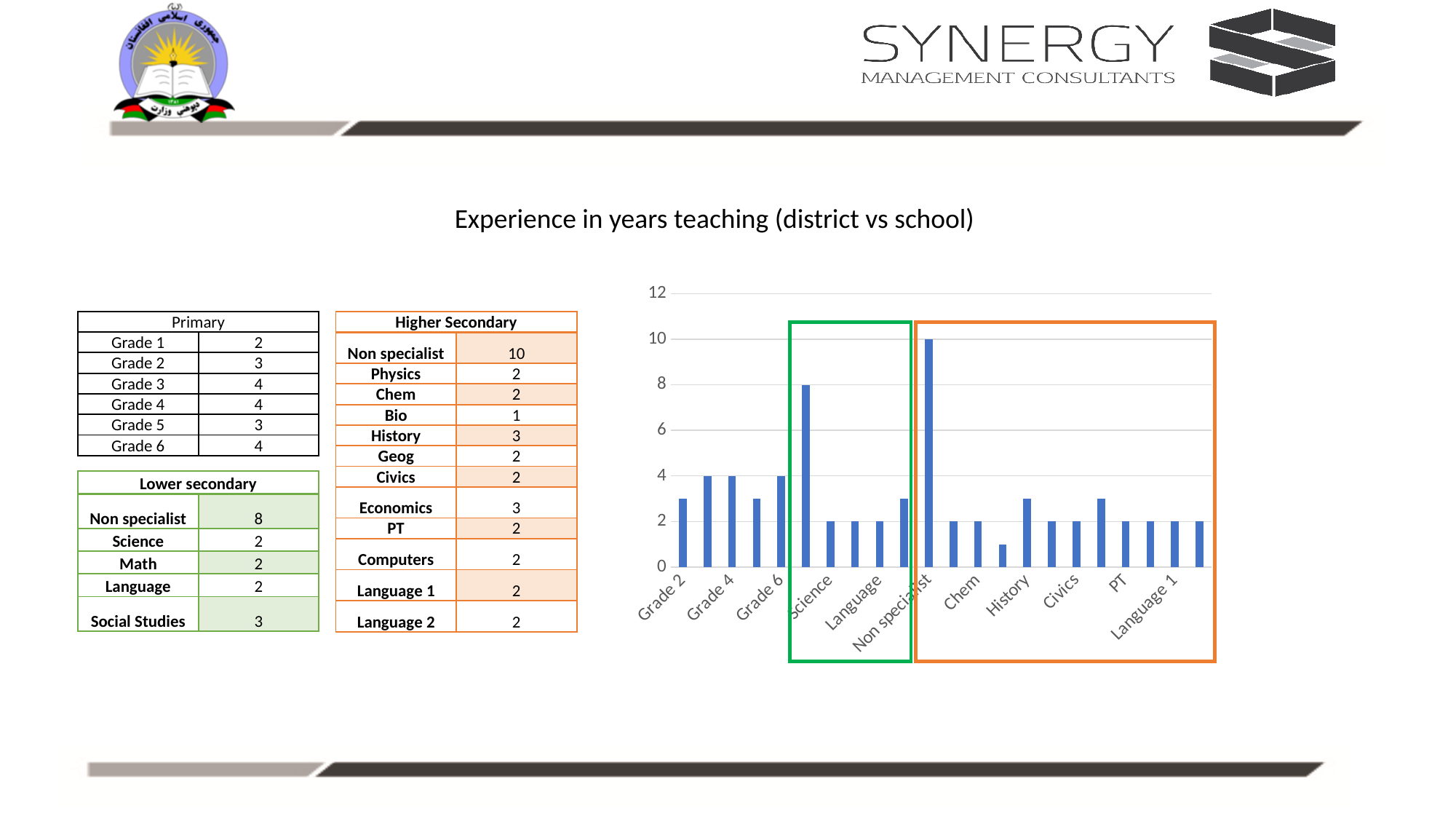
What is the title shown above the chart? Experience in years teaching (district vs school) What is the difference between the bar for Non specialist and the bar for Chem? 8 What is the value of the bar for Non specialist in the chart? 10 Which is larger in the chart, the bar for Non specialist or the bar for History? Non specialist What is the value of the bar for PT in the chart? 2 What kind of chart is shown on the slide? bar chart Is the value for Non specialist greater or less than 8? greater What is the value of the bar for Grade 2 in the chart? 3 What is the value of the bar for Grade 4 in the chart? 4 What is the value of the bar for History in the chart? 3 Which category has the highest bar in the chart? Non specialist What is the value of the bar for Chem in the chart? 2